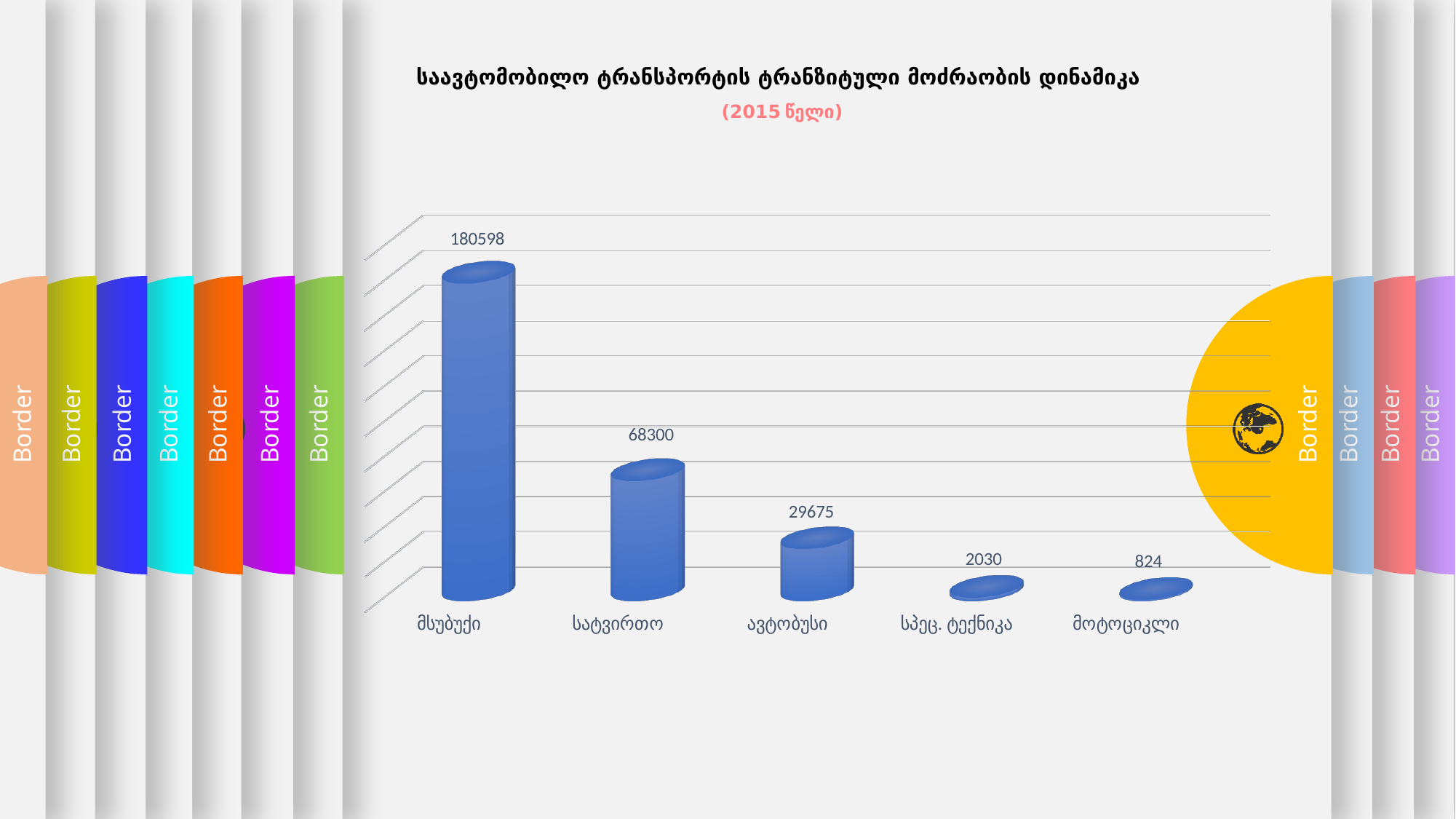
What is the value for სატვირთო? 68300 What is the difference between the values for სპეც. ტექნიკა and მოტოციკლი? 1206 What is the value for მსუბუქი? 180598 Which category has the highest value? მსუბუქი What is the value for მოტოციკლი? 824 What is the difference between the values for მსუბუქი and სატვირთო? 112298 What kind of chart is shown on the slide? Bar chart Which year is shown in the chart's subtitle? 2015 What is the value for ავტობუსი? 29675 Which is larger, the value for ავტობუსი or the value for სპეც. ტექნიკა? ავტობუსი Which category has the lowest value? მოტოციკლი How many categories are shown in the chart? 5